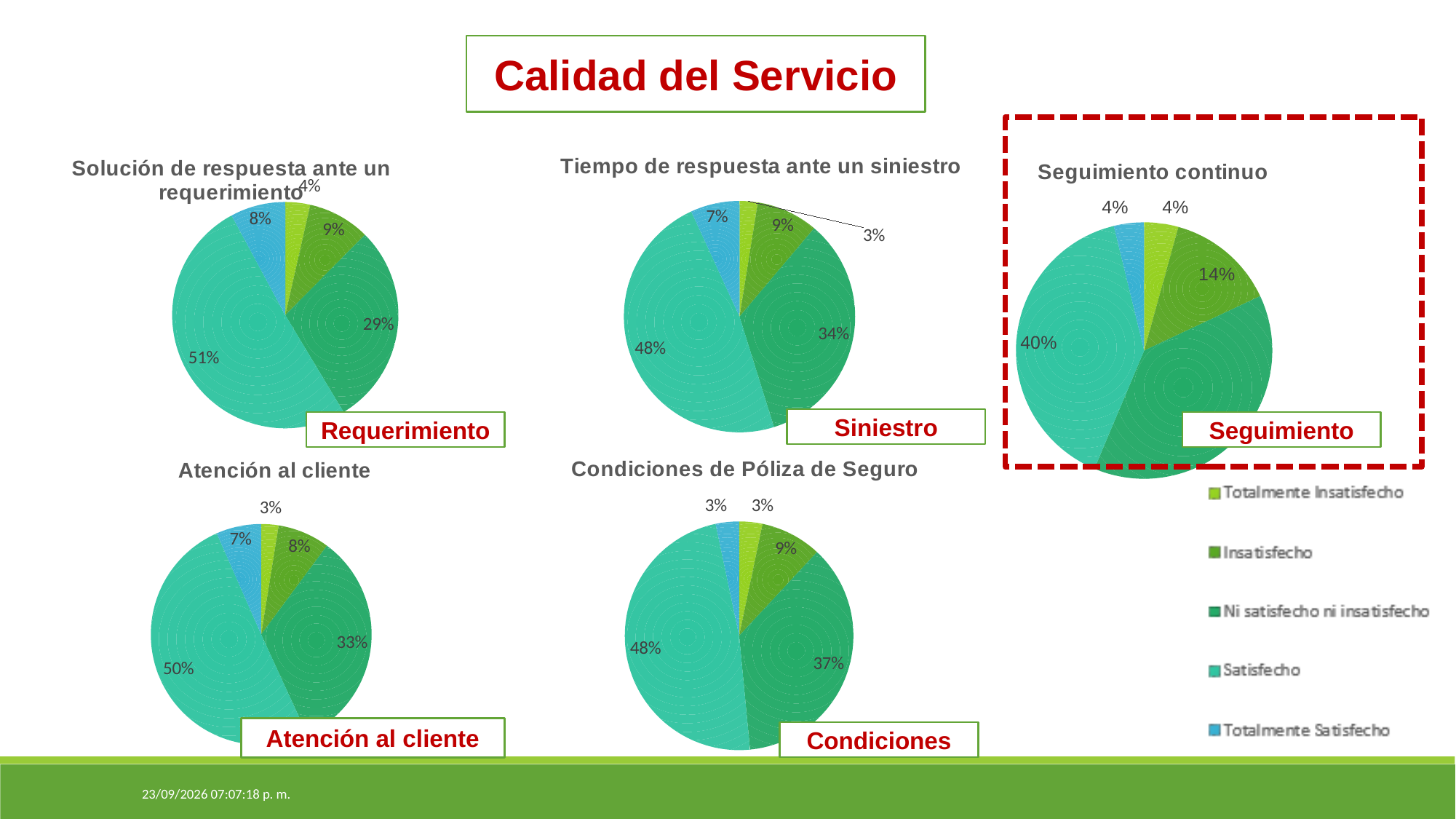
What kind of chart is 'Atención al cliente'? Pie chart In the 'Tiempo de respuesta ante un siniestro' chart, which is larger: the Insatisfecho slice or the Totalmente Satisfecho slice? Insatisfecho How many pie charts are shown on the slide? 5 In the 'Condiciones de Póliza de Seguro' chart, what percentage is shown for the Ni satisfecho ni insatisfecho slice? 37% In the 'Tiempo de respuesta ante un siniestro' chart, what percentage is shown for the Ni satisfecho ni insatisfecho slice? 34% How many categories does the shared legend list? 5 In the 'Atención al cliente' chart, what percentage is shown for the Totalmente Satisfecho slice? 7% In the 'Solución de respuesta ante un requerimiento' chart, which category has the smallest slice? Totalmente Insatisfecho In the 'Atención al cliente' chart, which category has the largest slice? Satisfecho In the 'Condiciones de Póliza de Seguro' chart, what is the difference between the Satisfecho and Ni satisfecho ni insatisfecho percentages? 11% In the 'Seguimiento continuo' chart, what percentage is shown for the Insatisfecho slice? 14% In the 'Solución de respuesta ante un requerimiento' chart, what percentage is shown for the Satisfecho slice? 51%